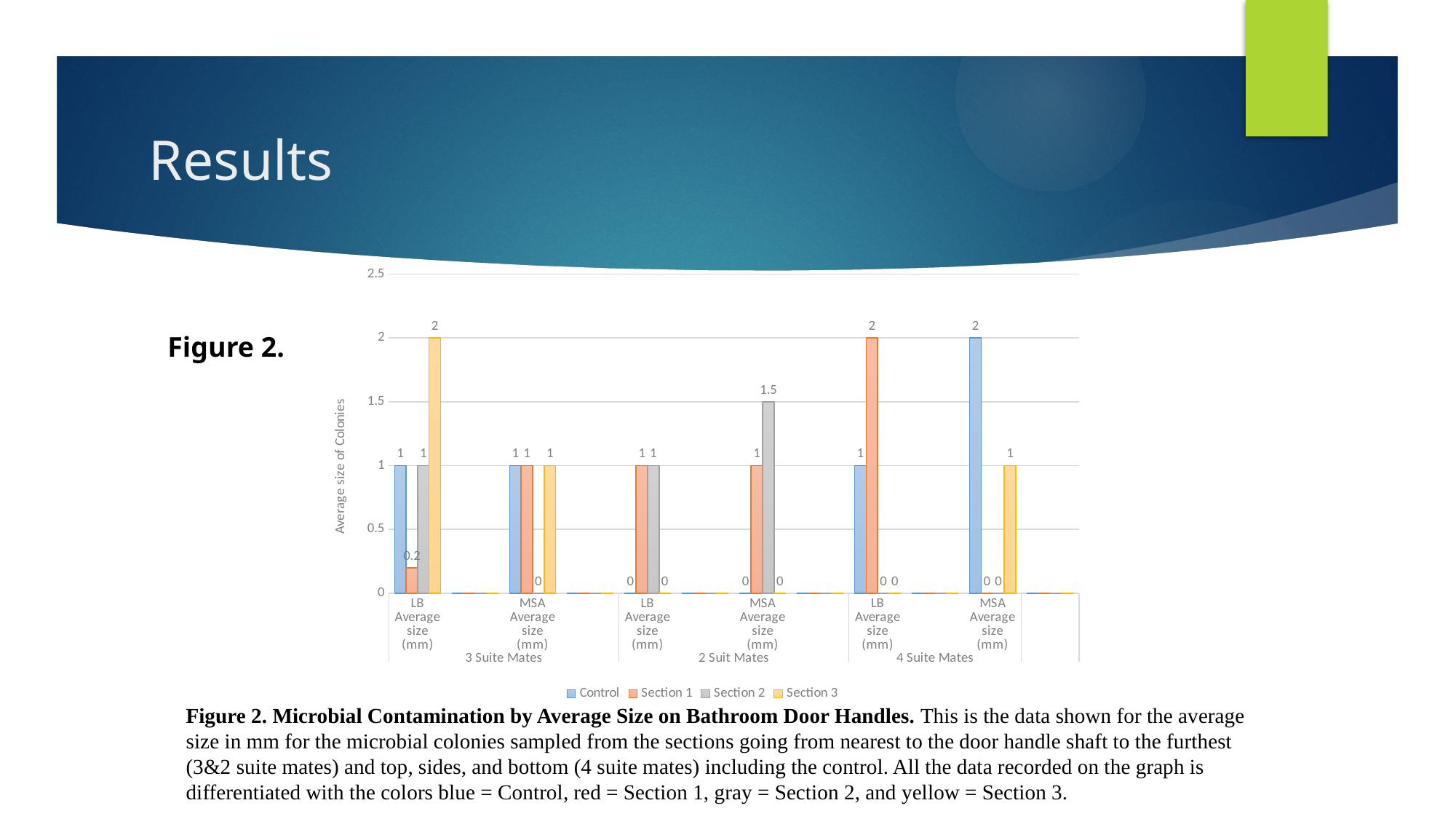
For LB Average size (mm) under 3 Suite Mates, which series has the lowest value? Section 1 What is the Control value for MSA Average size (mm) under 4 Suite Mates? 2 What is the Section 2 value for MSA Average size (mm) under 2 Suit Mates? 1.5 What is the Section 3 value for LB Average size (mm) under 3 Suite Mates? 2 How many series does the legend list? 4 What is the Section 1 value for LB Average size (mm) under 3 Suite Mates? 0.2 What kind of chart is shown on the slide? Bar chart For LB Average size (mm) under 3 Suite Mates, what is the difference between the Section 3 value and the Section 1 value? 1.8 Which colour represents Section 3 in the legend? Yellow For LB Average size (mm) under 4 Suite Mates, which series has the highest value? Section 1 What is the Section 1 value for LB Average size (mm) under 4 Suite Mates? 2 For MSA Average size (mm) under 2 Suit Mates, which is larger: Section 1 or Section 2? Section 2